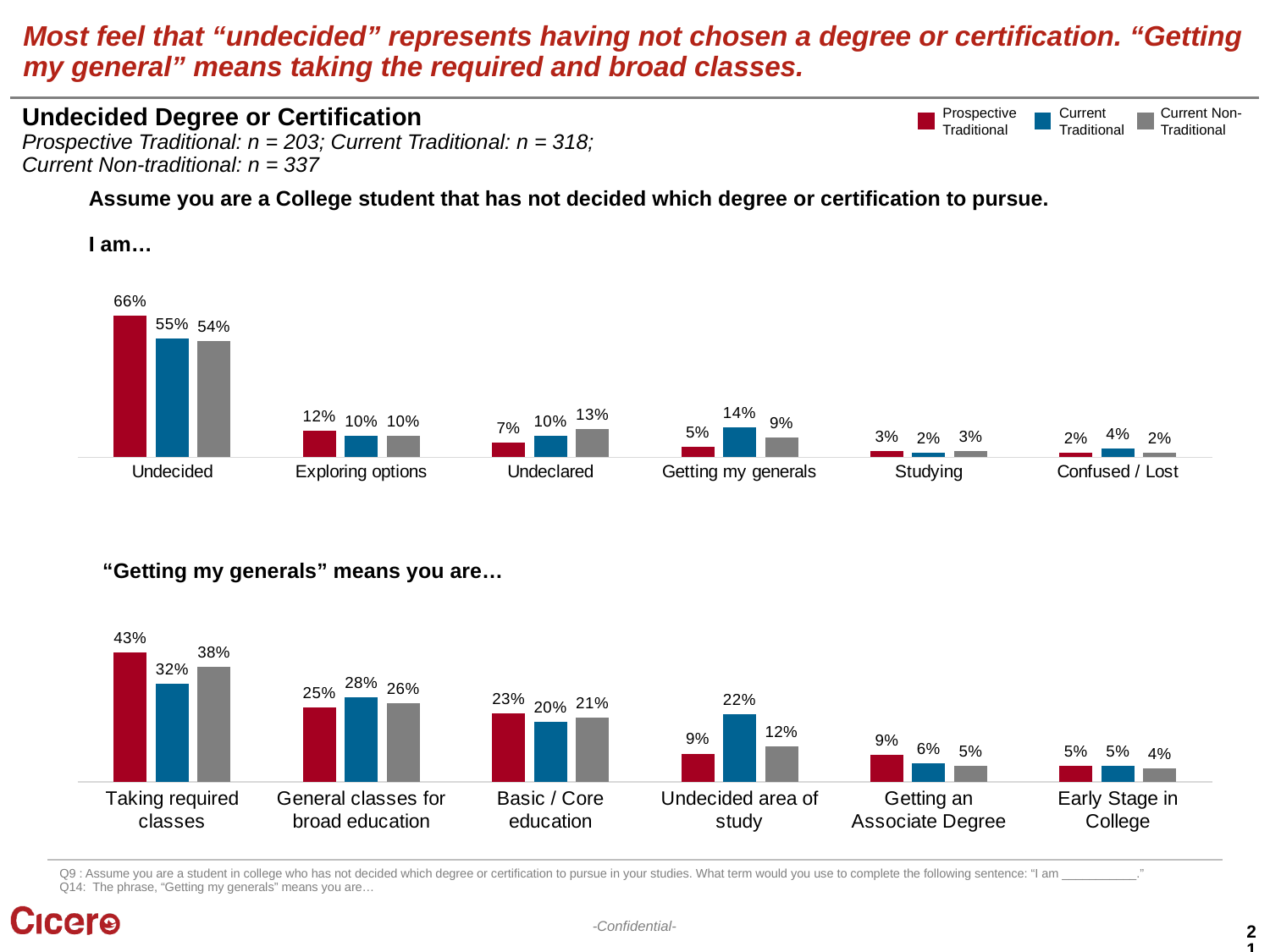
In the bottom chart ("Getting my generals" means you are…), which category has the lowest value for Current Non-Traditional? Early Stage in College In the bottom chart ("Getting my generals" means you are…), what is the difference between the Current Traditional and Prospective Traditional values for Undecided area of study? 13% In the top chart ("I am…"), which category has the highest value for Current Non-Traditional? Undecided What kind of chart is the bottom chart ("Getting my generals" means you are…)? Bar chart In the top chart ("I am…"), which is larger for Undeclared: Prospective Traditional or Current Non-Traditional? Current Non-Traditional Which colour represents the Current Traditional series in the legend? Blue How many categories are shown on the x axis of the top chart ("I am…")? 6 In the top chart ("I am…"), what is the value for Prospective Traditional in the Undecided category? 66% In the top chart ("I am…"), what is the difference between the Prospective Traditional and Current Traditional values for Undecided? 11% In the bottom chart ("Getting my generals" means you are…), what is the value for Current Non-Traditional in the Taking required classes category? 38% In the top chart ("I am…"), what is the value for Current Traditional in the Getting my generals category? 14% How many series does the legend list? 3